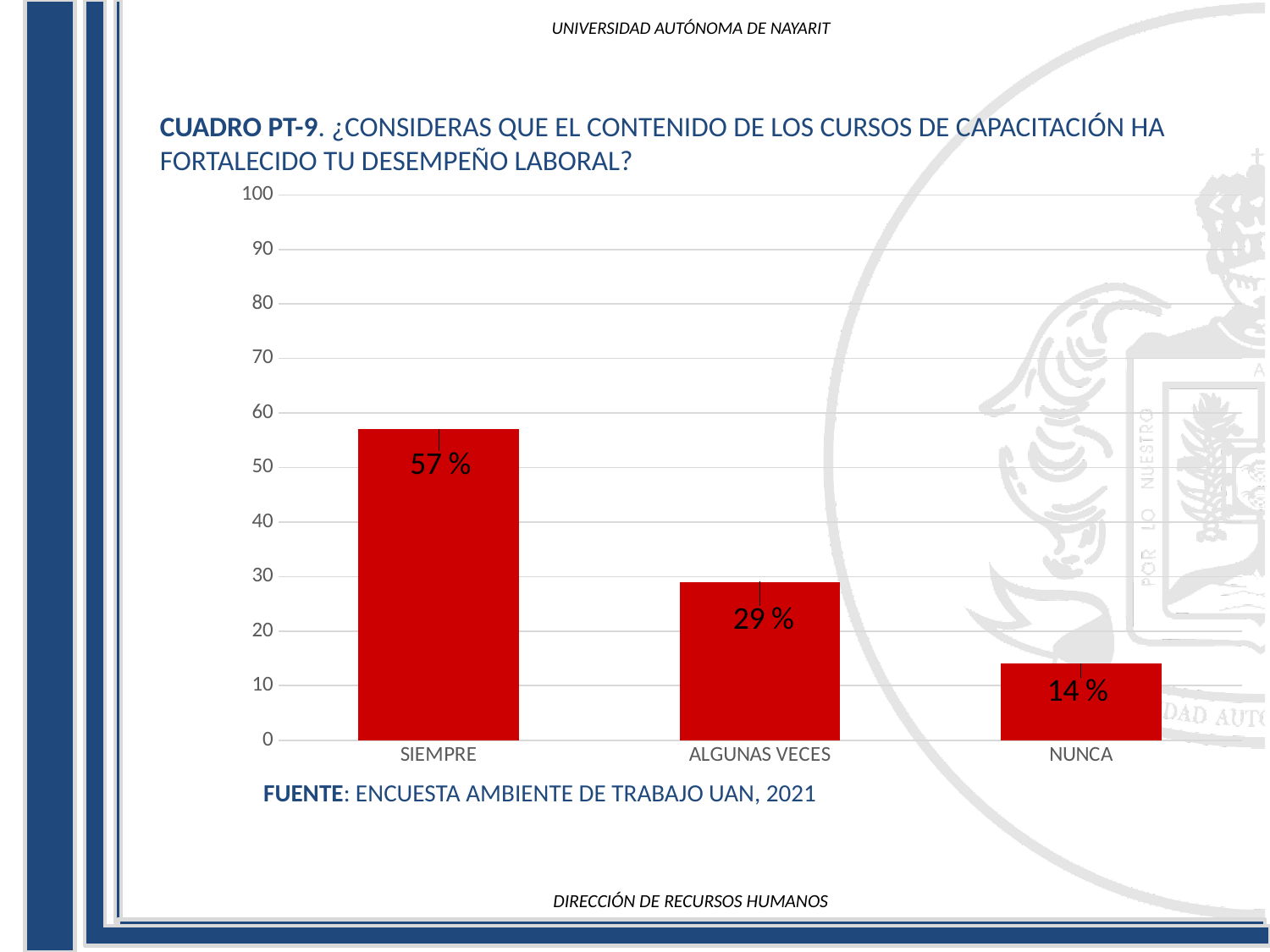
Which category has the highest value? SIEMPRE Which category has the lowest value? NUNCA What is the value for NUNCA? 14 % Is the value for SIEMPRE greater or less than 50? greater What is the difference between the values for ALGUNAS VECES and NUNCA? 15 % What is the difference between the values for SIEMPRE and ALGUNAS VECES? 28 % Do the values rise or fall from left to right along the x axis? fall Which is larger, the value for ALGUNAS VECES or the value for NUNCA? ALGUNAS VECES How many categories are shown on the x axis? 3 What is the value for SIEMPRE? 57 % What kind of chart is shown on the slide? bar chart What is the value for ALGUNAS VECES? 29 %